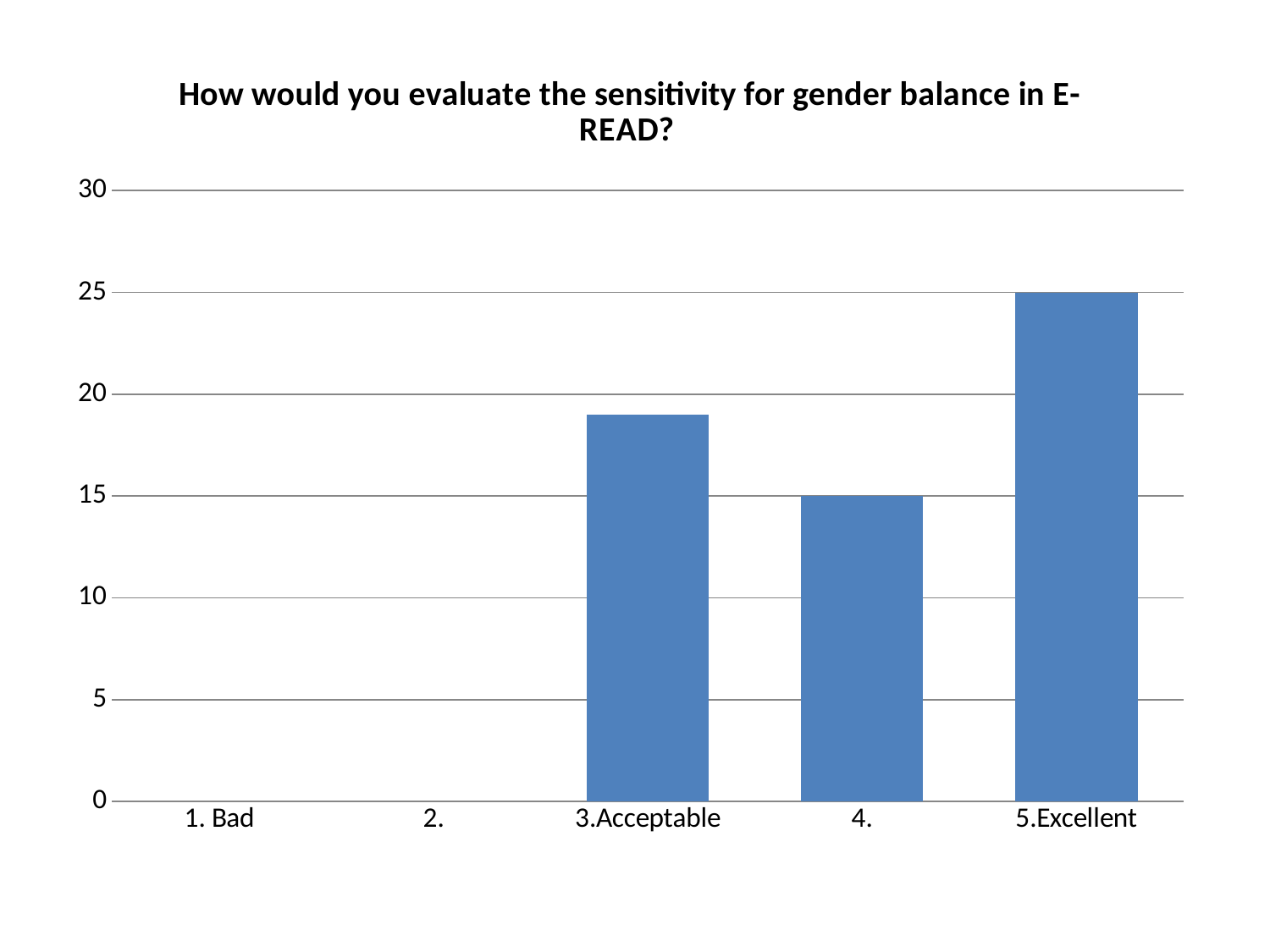
Which category has the highest value? 5.Excellent What is the difference between the values for 5.Excellent and 4.? 10 Is the value for 3.Acceptable greater or less than 20? less How many categories are shown on the x axis? 5 What is the value for 5.Excellent? 25 Which is larger, the value for 5.Excellent or the value for 3.Acceptable? 5.Excellent What is the value for 4.? 15 What is the highest value shown on the vertical axis? 30 Which is larger, the value for 3.Acceptable or the value for 4.? 3.Acceptable Is the value for 3.Acceptable greater or less than 15? greater What is the title of the chart? How would you evaluate the sensitivity for gender balance in E-READ? What type of chart is shown on the slide? bar chart